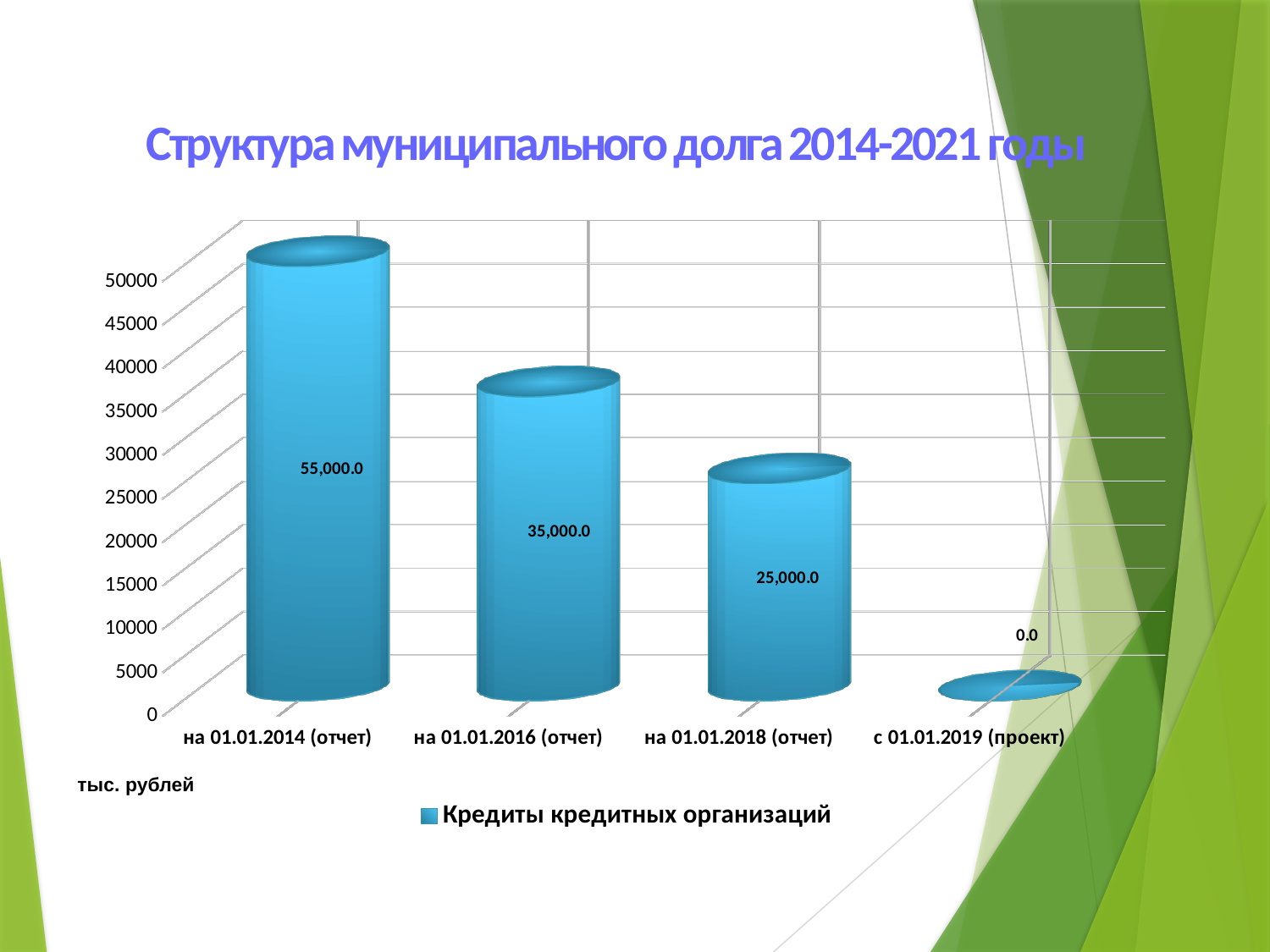
Which category has the highest value? на 01.01.2014 (отчет) What kind of chart is shown? bar chart Which is larger, the value for "на 01.01.2016 (отчет)" or "на 01.01.2018 (отчет)"? на 01.01.2016 (отчет) How many series does the legend list? 1 What is the value for "на 01.01.2016 (отчет)"? 35,000.0 What is the value for "на 01.01.2014 (отчет)"? 55,000.0 How many categories are shown on the x axis? 4 Which category has the lowest value? с 01.01.2019 (проект) What is the value for "с 01.01.2019 (проект)"? 0.0 Do the values rise or fall along the x axis? fall What is the difference between the values for "на 01.01.2014 (отчет)" and "на 01.01.2016 (отчет)"? 20,000.0 What is the value for "на 01.01.2018 (отчет)"? 25,000.0